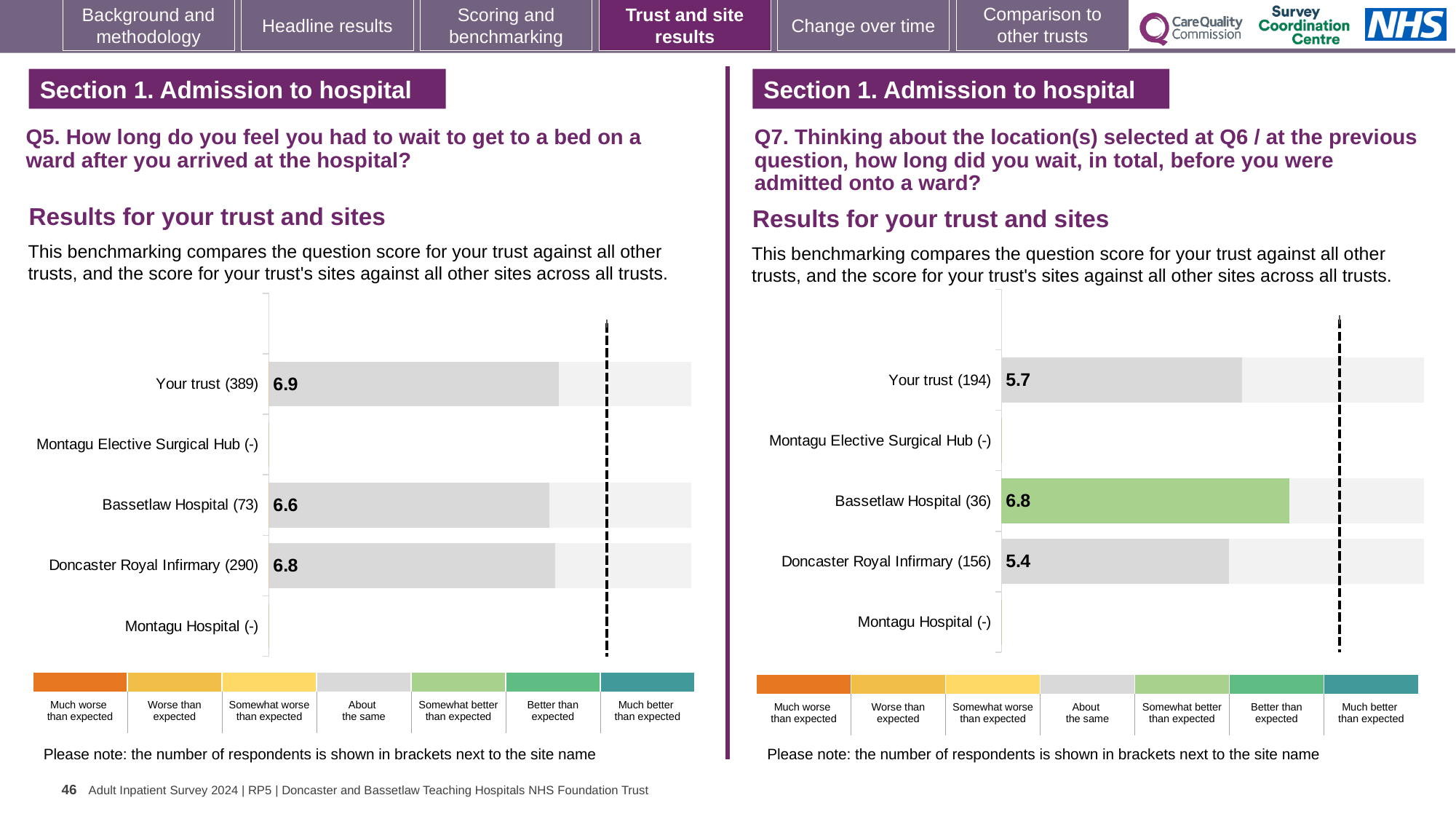
On the Q5 chart (left), what is the score for Bassetlaw Hospital? 6.6 What type of chart is used on the Q7 chart (right)? Bar chart On the Q5 chart (left), which site or trust row has the lowest score shown? Bassetlaw Hospital On the Q5 chart (left), what is the score for Your trust? 6.9 How many rows (trust and sites) are listed on the Q5 chart (left)? 5 On the Q7 chart (right), what is the score for Bassetlaw Hospital? 6.8 On the Q7 chart (right), what is the difference between the scores for Bassetlaw Hospital and Doncaster Royal Infirmary? 1.4 On the Q7 chart (right), which row has the highest score? Bassetlaw Hospital On the Q7 chart (right), which benchmark category does the colour of the Bassetlaw Hospital bar correspond to? Somewhat better than expected On the Q5 chart (left), what is the difference between the scores for Your trust and Doncaster Royal Infirmary? 0.1 On the Q7 chart (right), which has the larger score, Your trust or Doncaster Royal Infirmary? Your trust On the Q7 chart (right), what is the score for Doncaster Royal Infirmary? 5.4